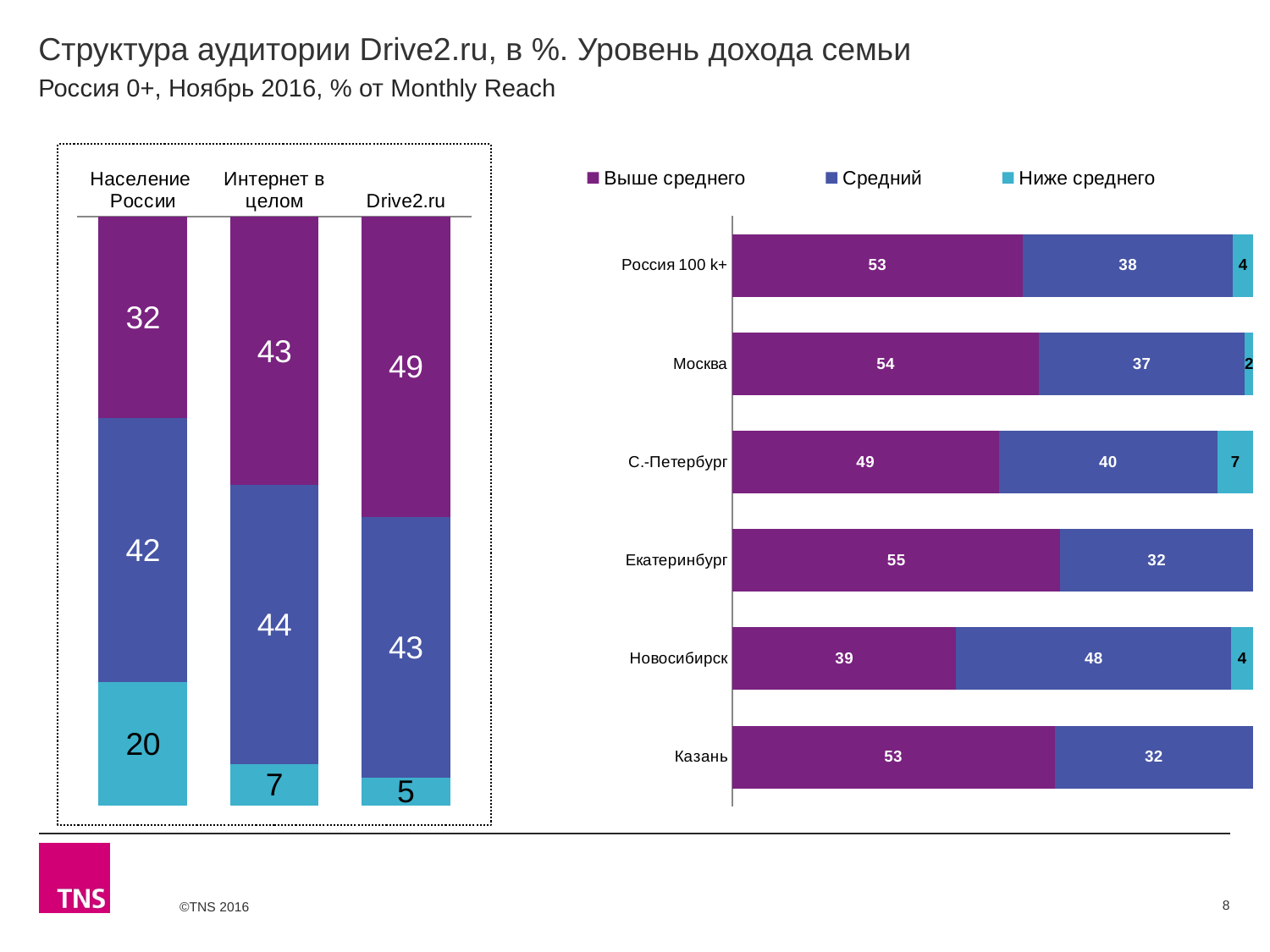
In the right chart, is the 'Выше среднего' value larger for Москва or for Новосибирск? Москва In the right chart, which city has the highest 'Выше среднего' value? Екатеринбург How many series does the legend of the right chart list? 3 In the left chart, what is the difference between the 'Выше среднего' values for Drive2.ru and Население России? 17 In the left chart, what is the value of the 'Средний' segment for Интернет в целом? 44 In the right chart, what is the 'Ниже среднего' value for С.-Петербург? 7 In the right chart, which city has the lowest 'Выше среднего' value? Новосибирск In the left chart, what is the value of the 'Ниже среднего' segment for Население России? 20 In the left chart, what is the total of the stacked bar for Drive2.ru? 97 In the right chart, what is the 'Средний' value for Новосибирск? 48 In the left chart, which category has the highest 'Ниже среднего' value? Население России In the left chart, what is the value of the 'Выше среднего' segment for Drive2.ru? 49